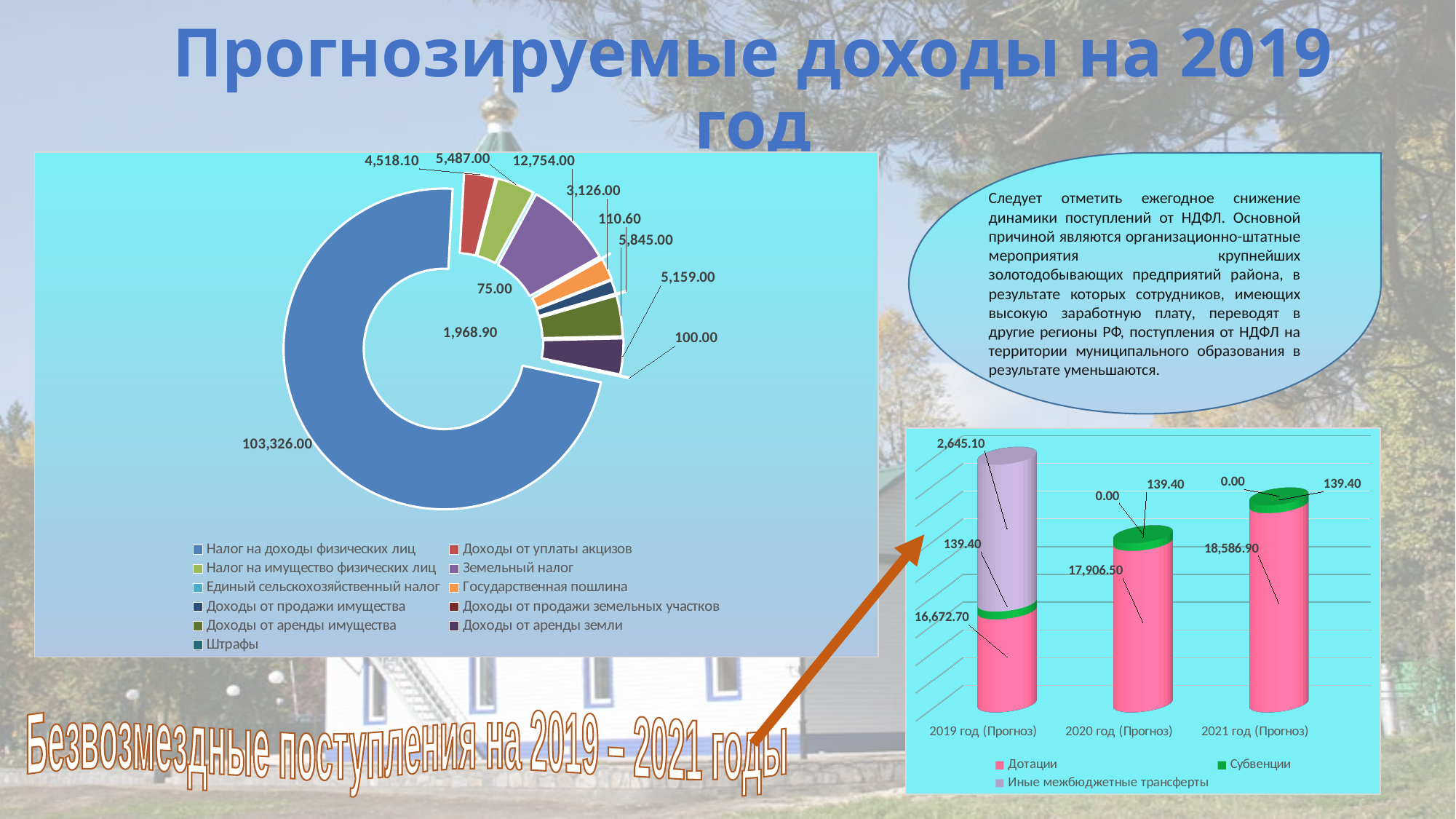
In the bar chart on the right, what is the total of the stacked bar for 2020 год (Прогноз)? 18,045.90 How many series does the legend of the bar chart on the right list? 3 What type of chart is the chart on the left of the slide? Doughnut chart In the doughnut chart on the left, what is the value of the largest segment? 103,326.00 In the bar chart on the right, what is the value of Дотации for 2021 год (Прогноз)? 18,586.90 How many entries does the legend of the doughnut chart on the left list? 11 In the bar chart on the right, what is the value of Иные межбюджетные трансферты for 2019 год (Прогноз)? 2,645.10 In the bar chart on the right, what is the difference between Дотации in 2021 год (Прогноз) and 2019 год (Прогноз)? 1,914.20 In the bar chart on the right, what is the value of Дотации for 2019 год (Прогноз)? 16,672.70 In the doughnut chart on the left, what is the value of the purple segment (Земельный налог)? 12,754.00 In the doughnut chart on the left, which legend entry corresponds to the largest segment? Налог на доходы физических лиц In the bar chart on the right, does the value of Дотации rise or fall from 2019 to 2021? Rises